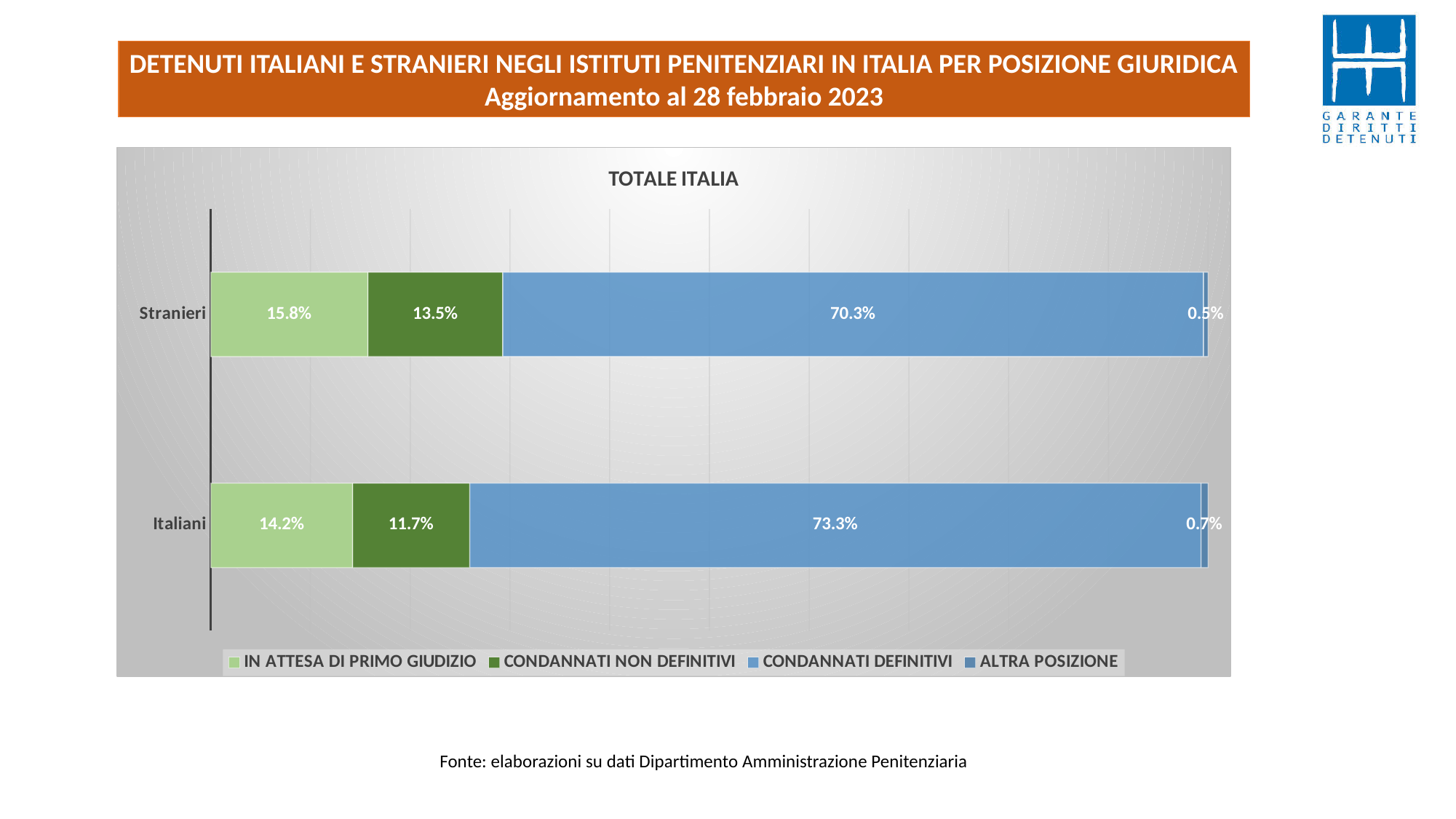
How many series does the legend list? 4 What kind of chart is shown on the slide? Stacked bar chart What is the value for CONDANNATI DEFINITIVI for Stranieri? 70.3% Which series has the smallest share for Stranieri? ALTRA POSIZIONE What is the difference between the CONDANNATI DEFINITIVI values for Italiani and Stranieri? 3.0% Which group has the higher CONDANNATI NON DEFINITIVI value, Stranieri or Italiani? Stranieri What is the value for IN ATTESA DI PRIMO GIUDIZIO for Italiani? 14.2% What is the difference between the IN ATTESA DI PRIMO GIUDIZIO values for Stranieri and Italiani? 1.6% What is the value for CONDANNATI NON DEFINITIVI for Stranieri? 13.5% What is the value for ALTRA POSIZIONE for Italiani? 0.7% Which series has the largest share for Italiani? CONDANNATI DEFINITIVI How many categories (bars) are shown in the chart? 2